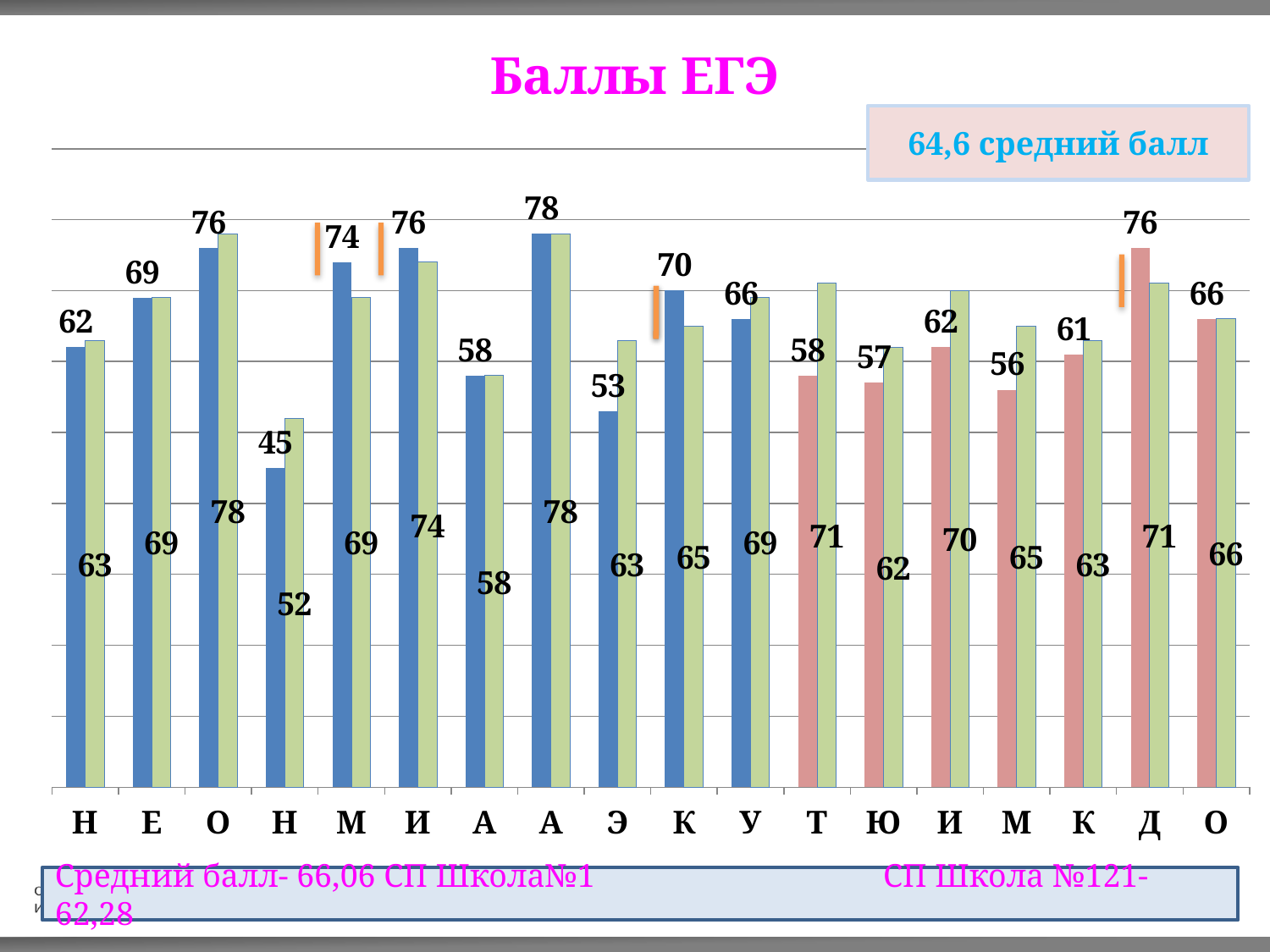
What value is printed above the first bar for category Д? 76 What is the highest value printed above a first bar in the chart? 78 For category Э, which is larger: the value above the first bar or the value inside the green bar? the value inside the green bar (63) What kind of chart is shown on the slide? bar chart What value is printed above the first bar for category Е? 69 Which category has the lowest value printed above its first bar? Н (the fourth category) What value is printed inside the green bar for category Э? 63 What value is printed above the first bar for category Ю? 57 What value is printed inside the green bar for category Т? 71 For category Т, what is the difference between the value inside the green bar (71) and the value above the first bar (58)? 13 How many categories are shown along the x axis of the chart? 18 What is the title of the chart? Баллы ЕГЭ